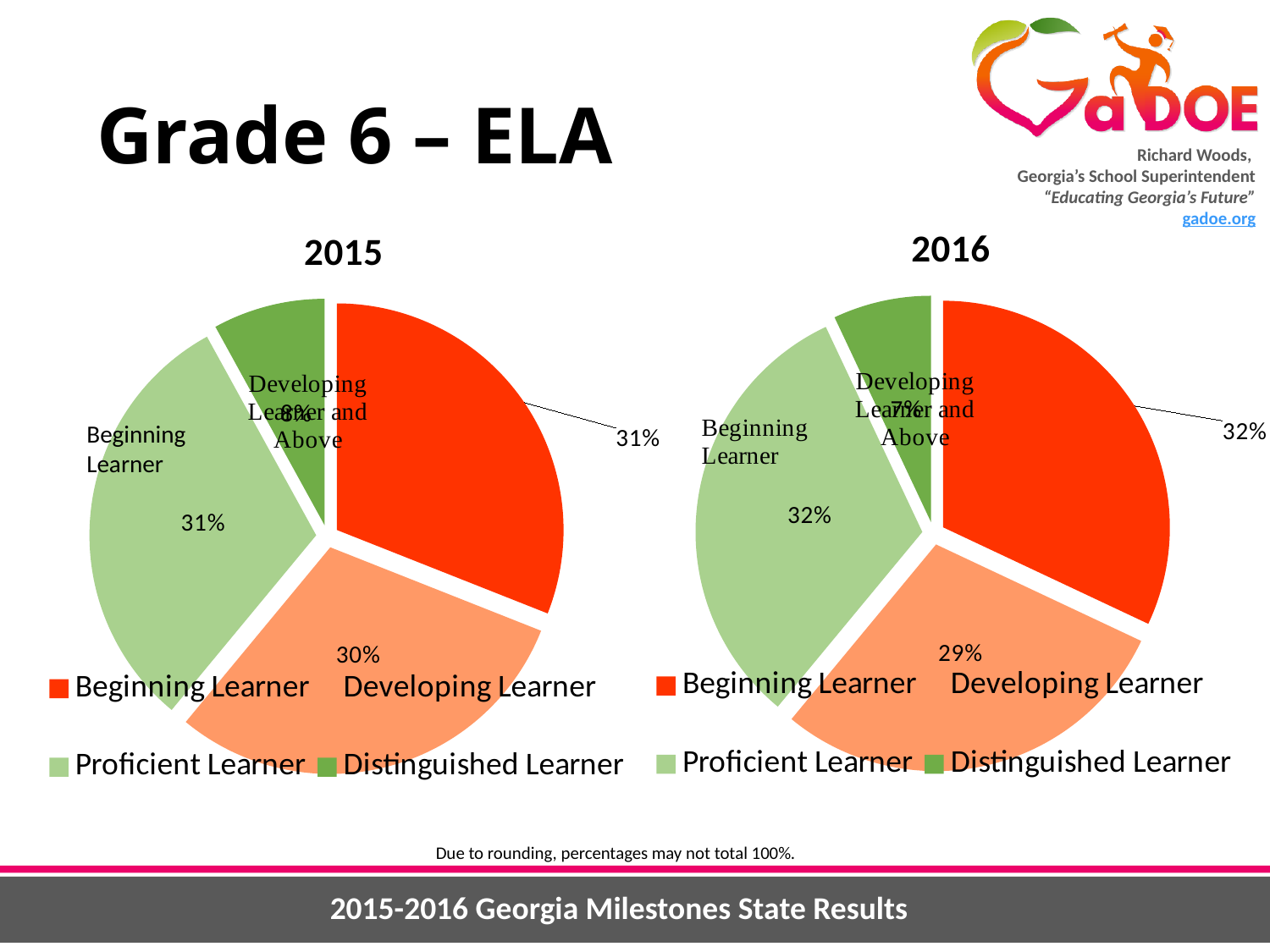
In the 2015 chart, what is the difference in percentage points between Developing Learner and Distinguished Learner? 22 percentage points Did the Developing Learner percentage rise or fall from the 2015 chart to the 2016 chart? Fall In the 2015 chart, what percentage is shown for Beginning Learner? 31% In the 2016 chart, what percentage is shown for Distinguished Learner? 7% In the 2016 chart, which is larger, Developing Learner or Distinguished Learner? Developing Learner In the 2016 chart, which category has the smallest slice? Distinguished Learner In the 2016 chart, what percentage is shown for Proficient Learner? 32% How many slices does the 2015 pie chart have? 4 In the 2015 chart, which category has the smallest slice? Distinguished Learner In the 2016 chart, what percentage is shown for Developing Learner? 29% In the 2015 chart, what percentage is shown for Developing Learner? 30% What kind of chart is used for the 2016 data? Pie chart